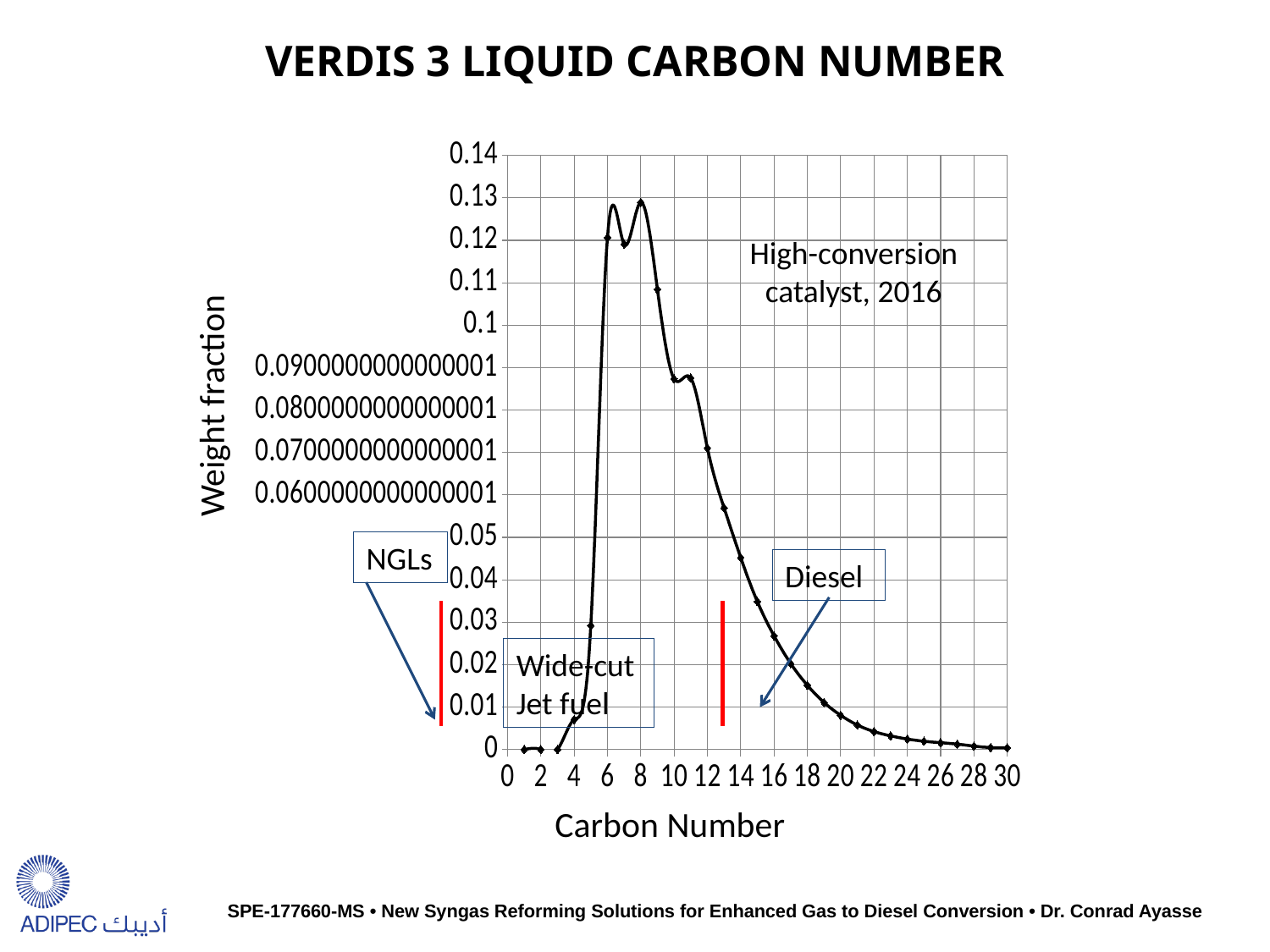
Is the weight fraction at carbon number 20 greater or less than 0.02? less What is the label of the vertical axis? Weight fraction Is the weight fraction at carbon number 8 greater or less than 0.12? greater Which has the larger weight fraction, carbon number 12 or carbon number 22? carbon number 12 What is the weight fraction at carbon number 2? 0 Is the weight fraction at carbon number 10 greater or less than 0.07? greater Which has the larger weight fraction, carbon number 6 or carbon number 16? carbon number 6 What is the title of the chart? VERDIS 3 LIQUID CARBON NUMBER What kind of chart is shown on the slide? line chart Do the weight fraction values rise or fall as the carbon number increases from 12 to 30? fall